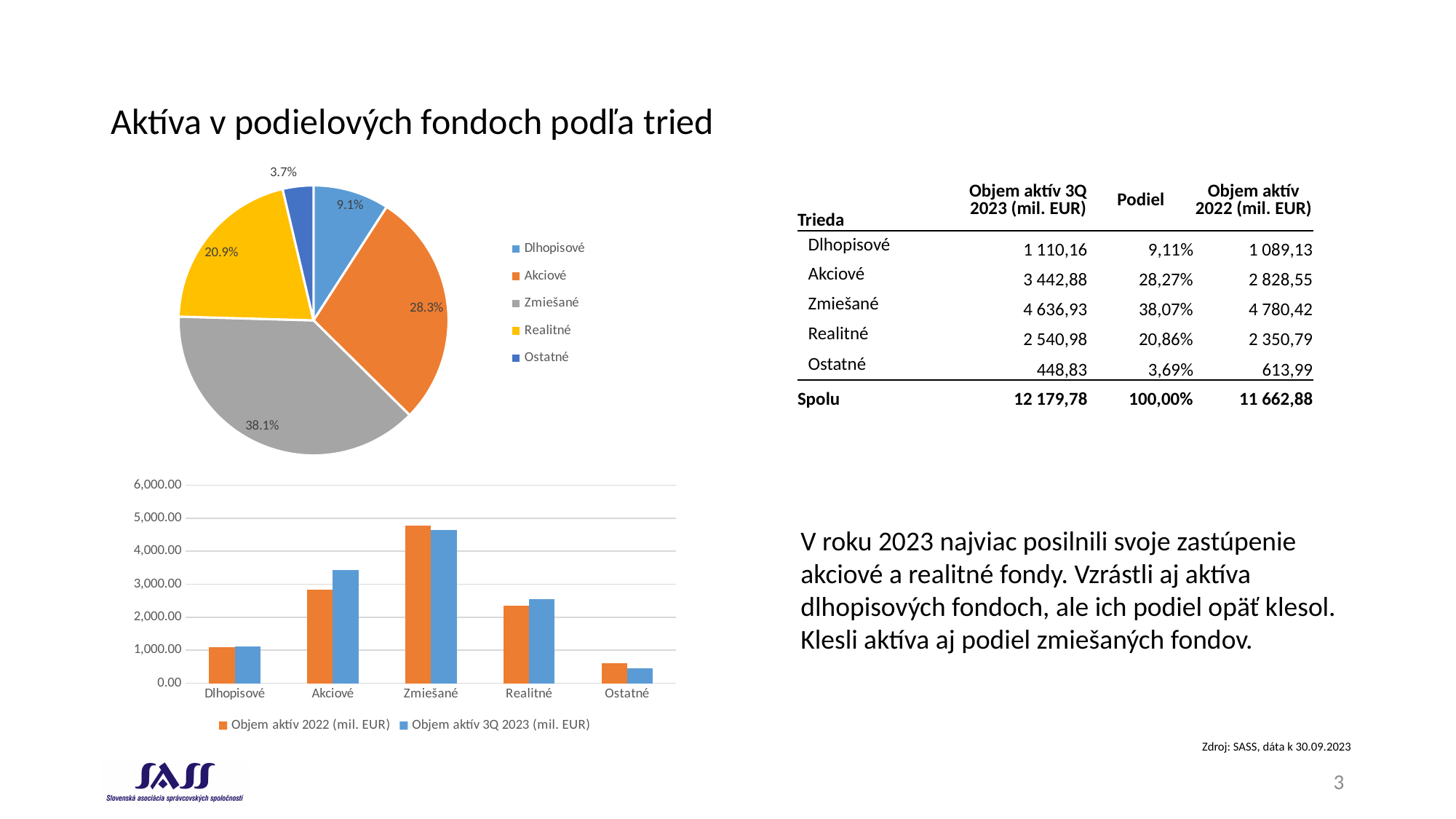
What kind of chart is the chart at the bottom left of the slide? bar chart How many series does the legend of the bottom bar chart list? 2 In the pie chart, which category has the smallest slice? Ostatné How many slices does the pie chart have? 5 In the pie chart, which category has the largest slice? Zmiešané In the pie chart, what share is shown for Zmiešané? 38.1% In the pie chart, what share is shown for Ostatné? 3.7% In the pie chart, what colour is the Realitné slice? yellow In the bottom bar chart, is the value for Zmiešané in the Objem aktív 2022 (mil. EUR) series greater or less than 4,000.00? greater In the bottom bar chart, which is larger for Akciové: Objem aktív 2022 (mil. EUR) or Objem aktív 3Q 2023 (mil. EUR)? Objem aktív 3Q 2023 (mil. EUR) In the pie chart, what is the difference between the shares of Realitné and Dlhopisové? 11.8% In the pie chart, what share is shown for Akciové? 28.3%